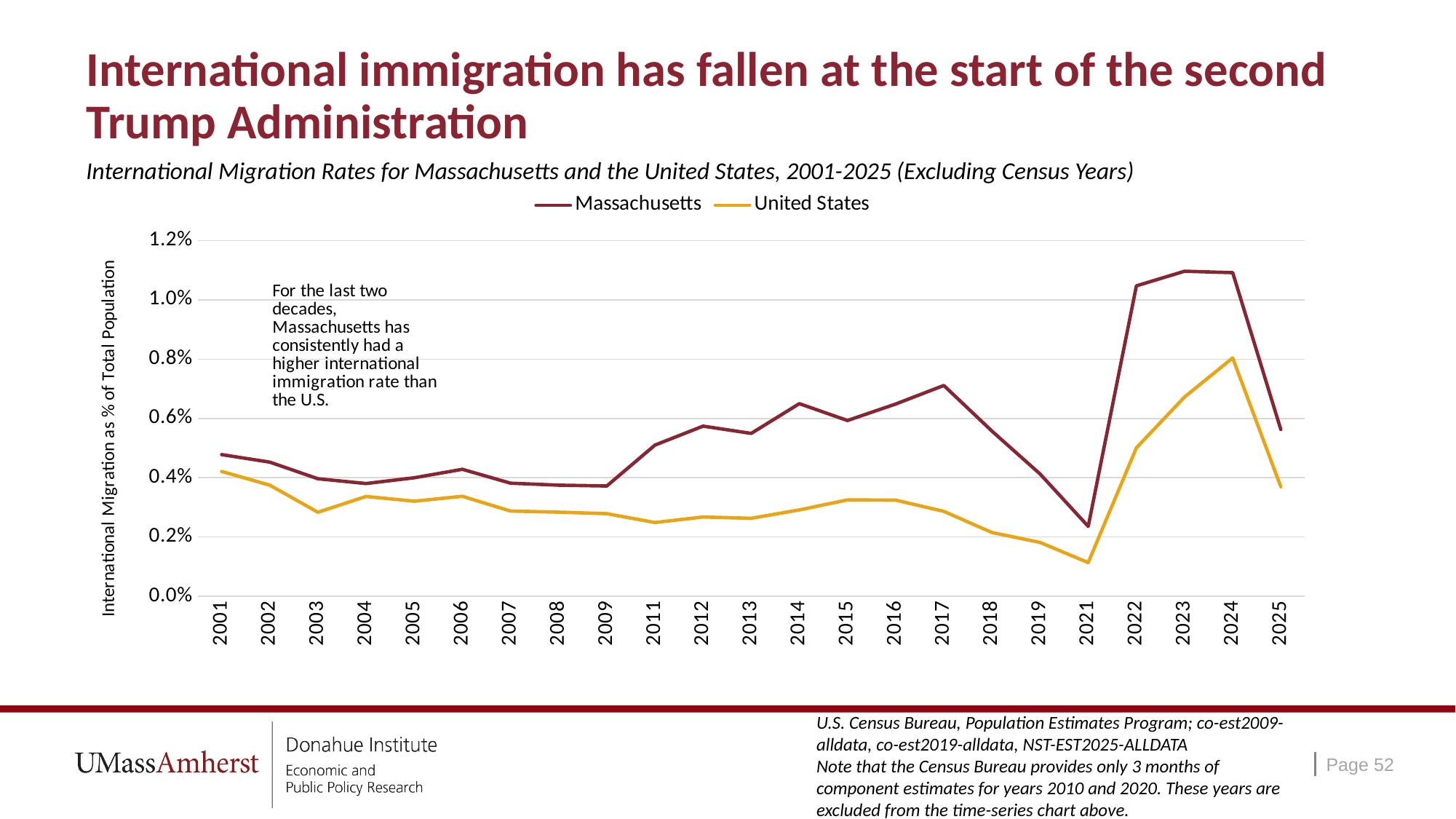
In which year does the United States line reach its highest value? 2024 Is the Massachusetts value for 2023 greater or less than 1.0%? greater How many series does the legend list? 2 Do both lines rise or fall from 2024 to 2025? fall Is the United States value for 2024 greater or less than 0.6%? greater What kind of chart is shown on the slide? line chart Which two series are shown in the legend? Massachusetts and United States In which year does the Massachusetts line reach its lowest value? 2021 In 2017, which series has the higher value, Massachusetts or United States? Massachusetts Is the United States value for 2021 greater or less than 0.2%? less In which year does the United States line reach its lowest value? 2021 How many years are plotted along the x axis? 23